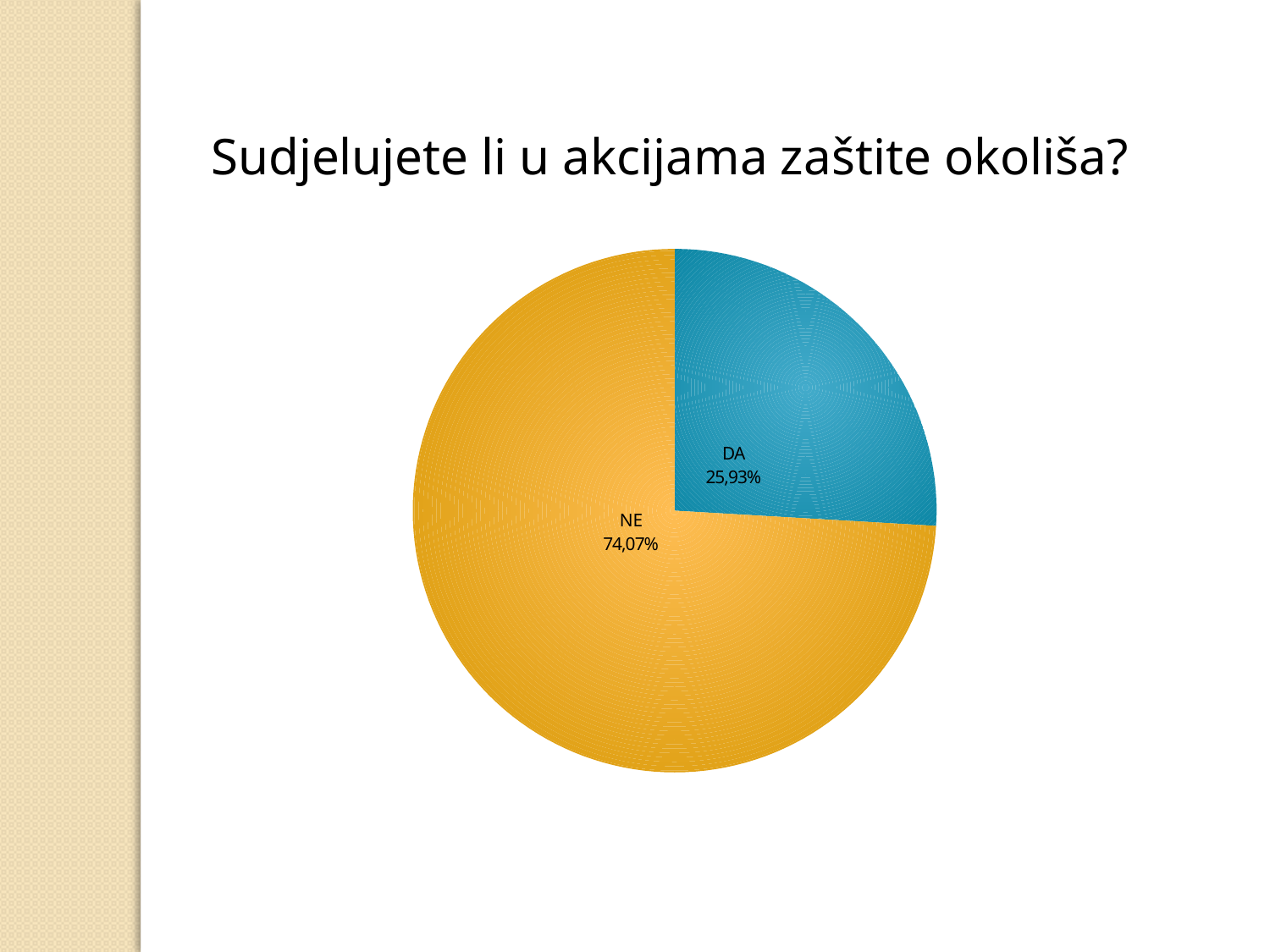
What share of the pie does the DA slice represent? 25,93% What is the difference between the NE share and the DA share? 48,14% What colour is the NE slice? orange Which is larger, the DA slice or the NE slice? NE What share of the pie does the NE slice represent? 74,07% What is the title of the slide above the chart? Sudjelujete li u akcijama zaštite okoliša? How many slices does the pie chart have? 2 What kind of chart is shown on the slide? pie chart Which slice is the smallest? DA Is the share for DA greater or less than 50%? less Which slice is the largest? NE